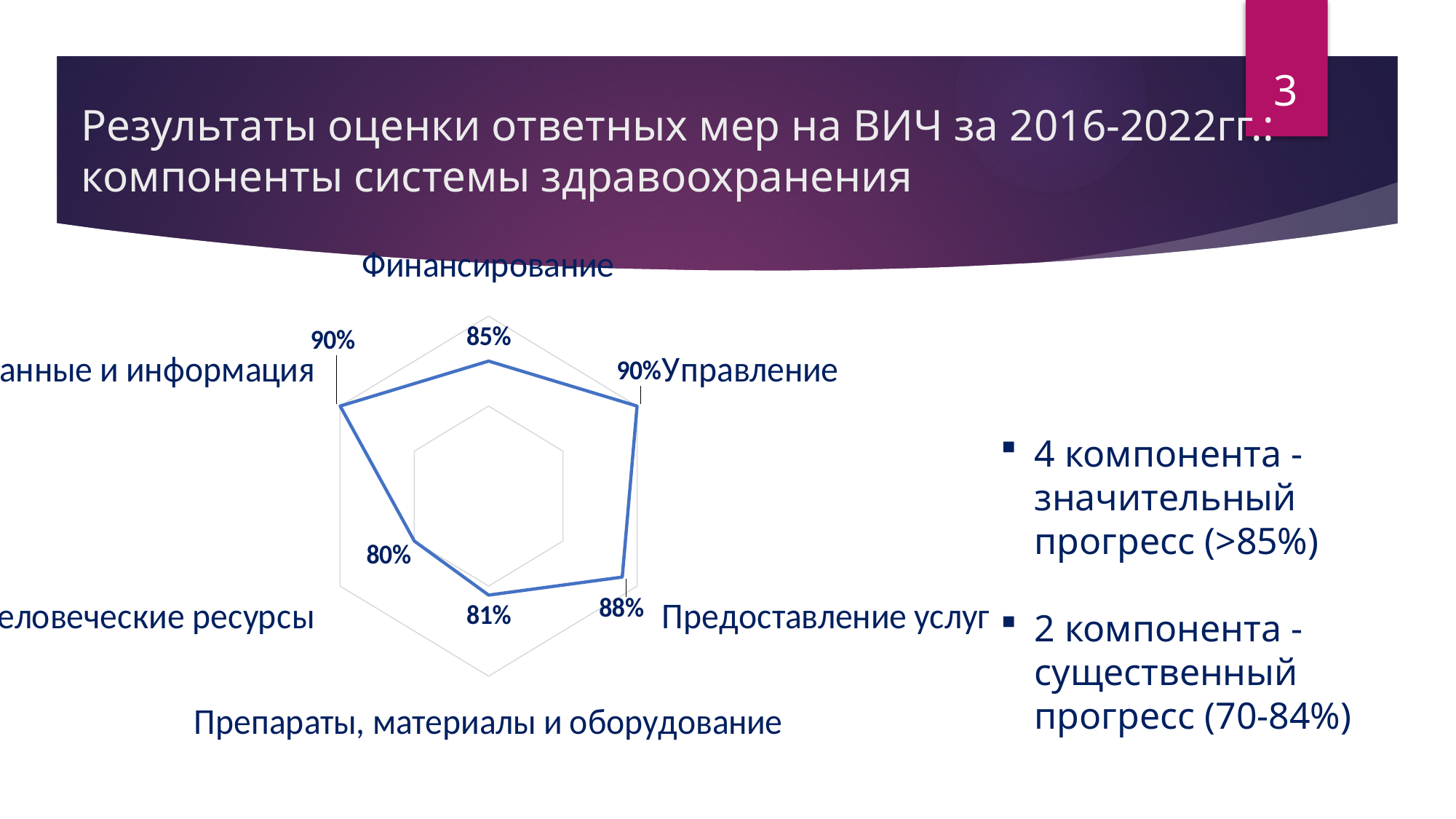
What kind of chart is shown on the slide? radar chart What colour is the data line plotted on the radar chart? blue What is the difference between the values for Предоставление услуг and Препараты, материалы и оборудование? 7% Which is larger, the value for Управление or the value for Препараты, материалы и оборудование? Управление Which is larger, the value for Финансирование or the value for Предоставление услуг? Предоставление услуг How many categories (axes) does the radar chart have? 6 What is the difference between the values for Управление and Финансирование? 5% What is the difference between the values for Управление and Предоставление услуг? 2% What is the value for Управление? 90% What is the value for Препараты, материалы и оборудование? 81% What is the value for Финансирование? 85% What is the value for Предоставление услуг? 88%